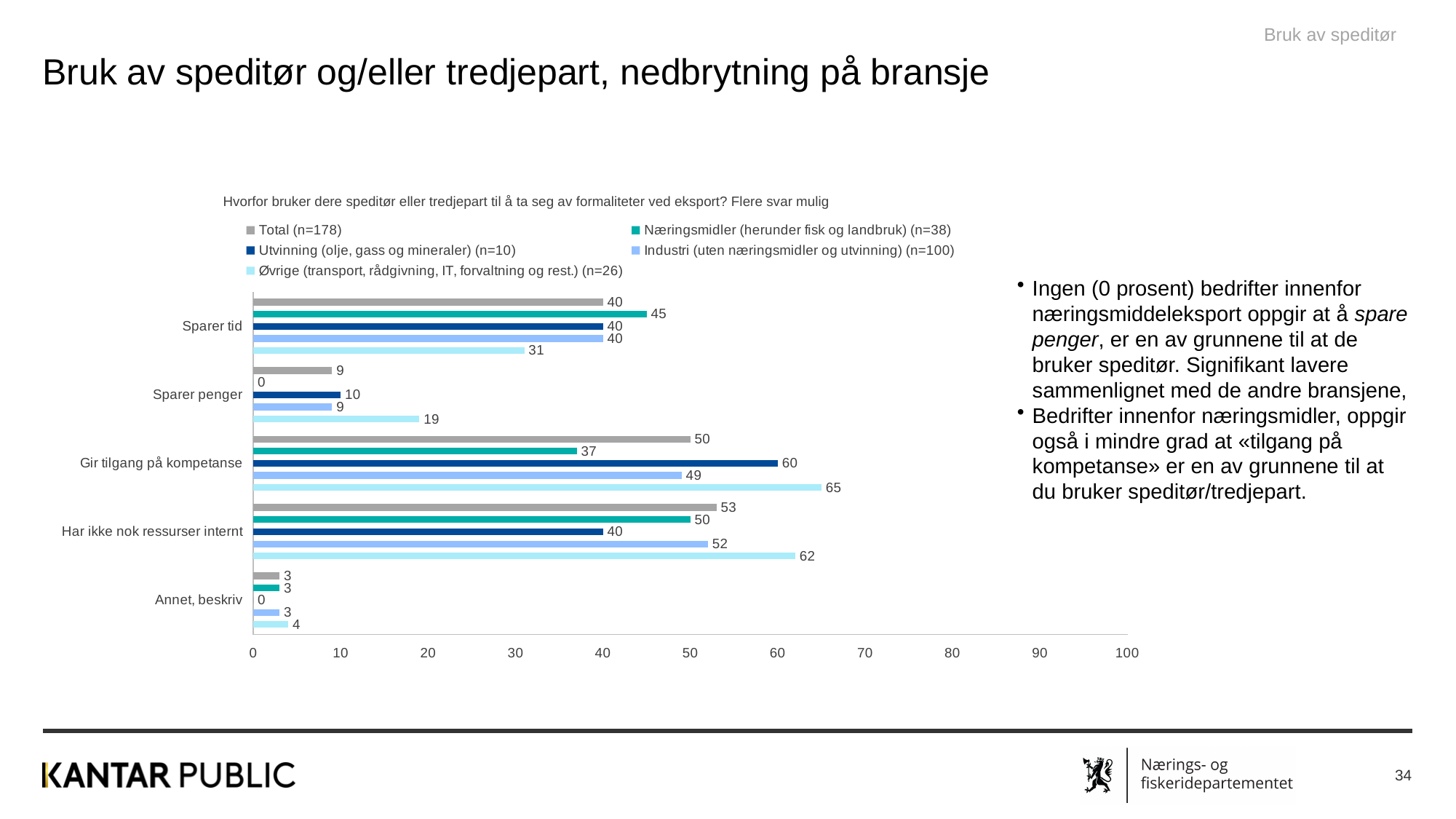
What is the value for Total (n=178) in the category 'Sparer tid'? 40 What is the value for Utvinning (olje, gass og mineraler) (n=10) in the category 'Annet, beskriv'? 0 What is the difference between the Utvinning (olje, gass og mineraler) (n=10) value and the Næringsmidler (herunder fisk og landbruk) (n=38) value in the category 'Gir tilgang på kompetanse'? 23 Which series has the lowest value in the category 'Gir tilgang på kompetanse'? Næringsmidler (herunder fisk og landbruk) (n=38) Which series has the highest value in the category 'Har ikke nok ressurser internt'? Øvrige (transport, rådgivning, IT, forvaltning og rest.) (n=26) What is the value for Øvrige (transport, rådgivning, IT, forvaltning og rest.) (n=26) in the category 'Gir tilgang på kompetanse'? 65 What is the value for Næringsmidler (herunder fisk og landbruk) (n=38) in the category 'Sparer penger'? 0 How many categories are shown on the vertical axis of the chart? 5 What kind of chart is shown on the slide? bar chart Is the value for Industri (uten næringsmidler og utvinning) (n=100) in the category 'Har ikke nok ressurser internt' greater or less than 50? greater How many series does the legend list? 5 In the category 'Sparer tid', which is larger: the value for Næringsmidler (herunder fisk og landbruk) (n=38) or the value for Øvrige (transport, rådgivning, IT, forvaltning og rest.) (n=26)? Næringsmidler (herunder fisk og landbruk) (n=38)